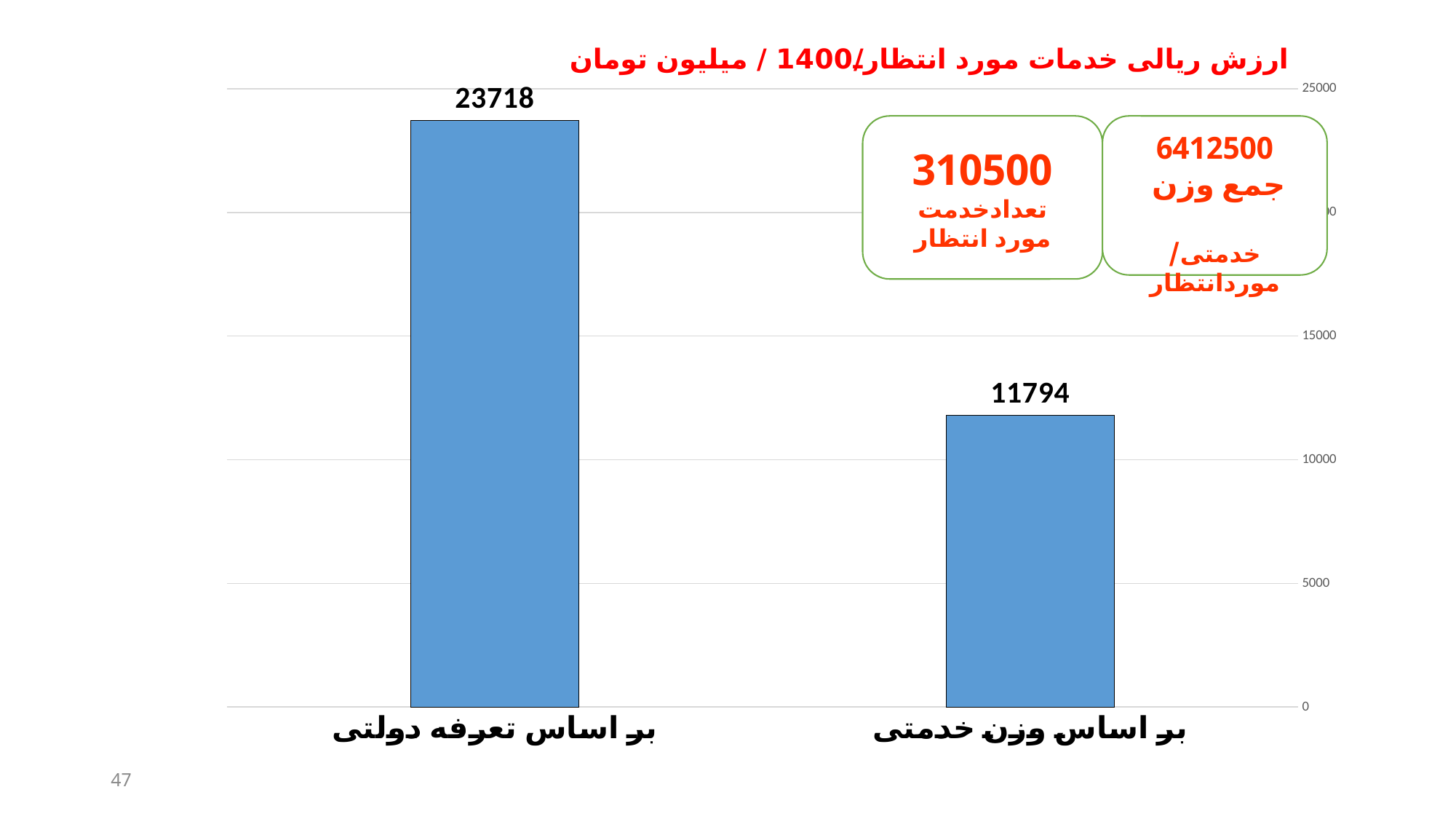
Is the value for "بر اساس وزن خدمتی" greater or less than 15000? less What is the maximum value shown on the vertical axis of the chart? 25000 Which is larger: the value for "بر اساس تعرفه دولتی" or the value for "بر اساس وزن خدمتی"? بر اساس تعرفه دولتی How many bars are shown in the chart? 2 Which category has the lowest value in the chart? بر اساس وزن خدمتی What number is shown in the callout box labelled "تعداد خدمت مورد انتظار"? 310500 Is the value for "بر اساس تعرفه دولتی" greater or less than 20000? greater Which category has the highest value in the chart? بر اساس تعرفه دولتی What kind of chart is shown on the slide? bar chart What is the value of the bar labelled "بر اساس وزن خدمتی"? 11794 What is the value of the bar labelled "بر اساس تعرفه دولتی"? 23718 What is the difference between the values for "بر اساس تعرفه دولتی" and "بر اساس وزن خدمتی"? 11924